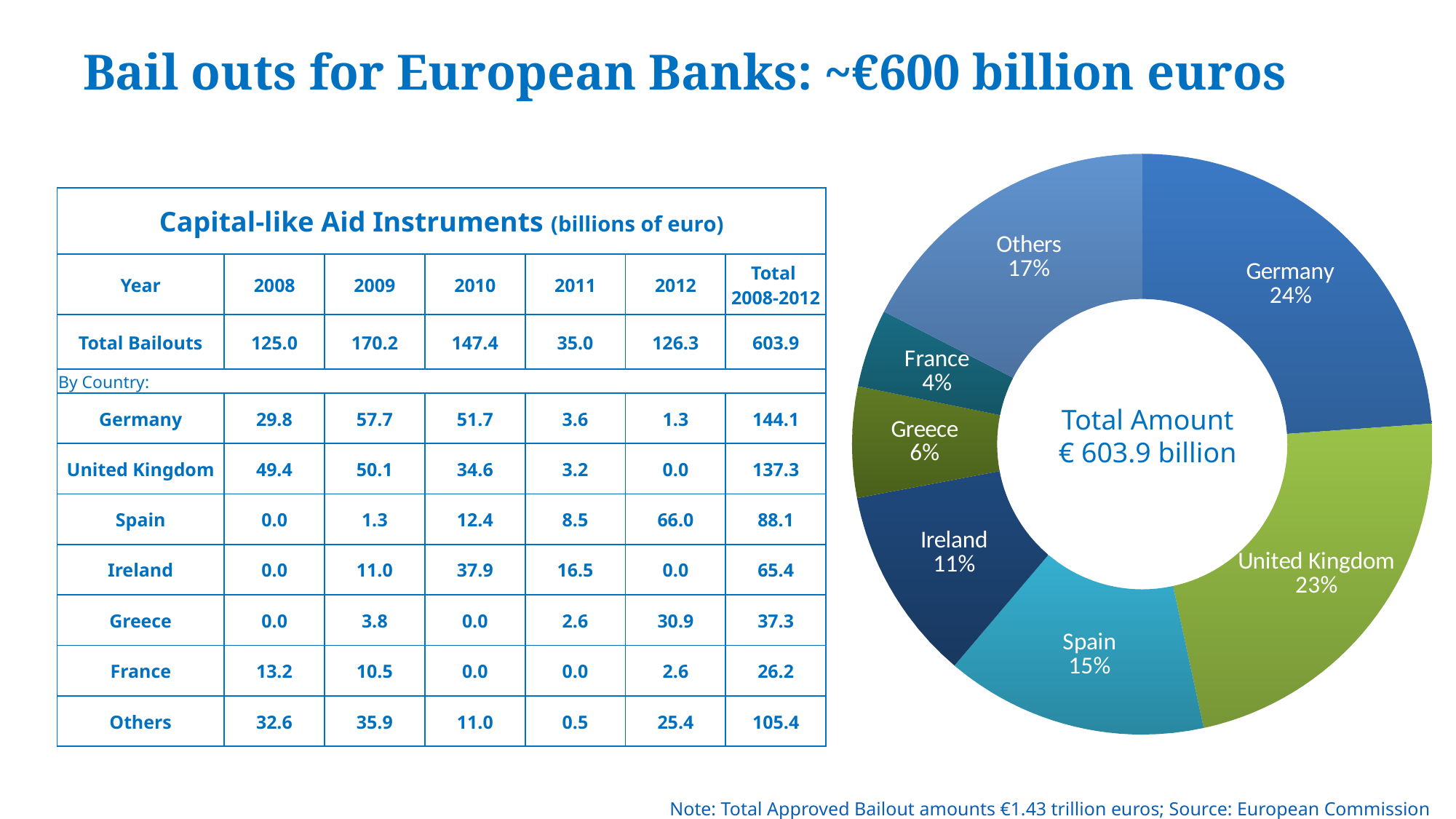
In the pie chart, what share of the bailouts does Germany account for? 24% Which labelled slice in the pie chart is the smallest? France Which country has the largest slice in the pie chart? Germany In the pie chart, what percentage is shown for Greece? 6% In the pie chart, what percentage is shown for Ireland? 11% In the pie chart, which has the larger share: Others or Spain? Others How many slices does the pie chart have? 7 What total amount is printed in the centre of the pie chart? € 603.9 billion In the pie chart, how many percentage points larger is Germany's share than the United Kingdom's? 1 In the pie chart, how many percentage points larger is Spain's share than Ireland's? 4 What kind of chart is shown on the right of the slide? Pie chart (donut) In the pie chart, what percentage is shown for Spain? 15%